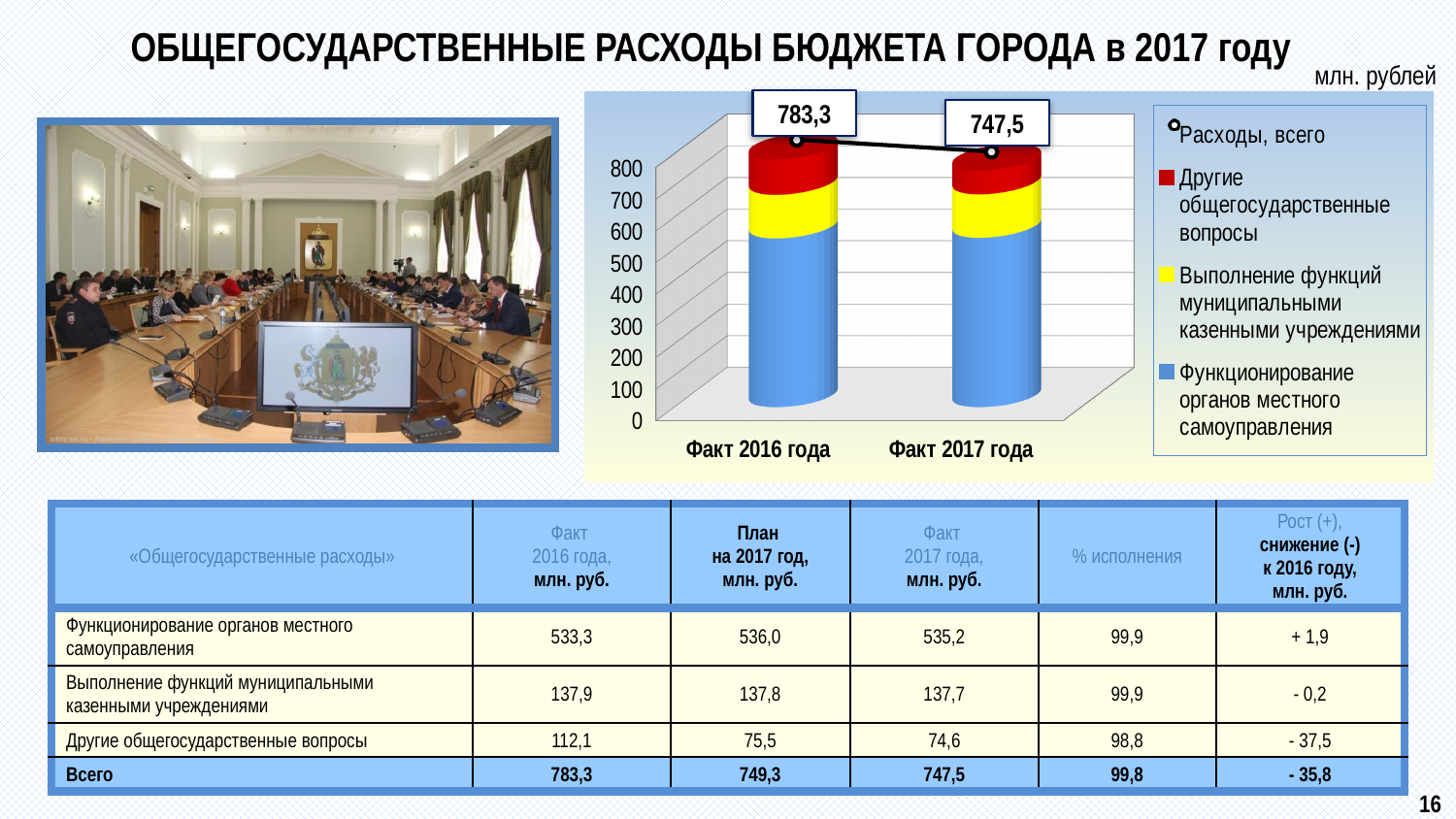
What is the value of «Расходы, всего» for «Факт 2016 года»? 783,3 Which category shows the lowest total expenditure? Факт 2017 года Do the total expenditures rise or fall from «Факт 2016 года» to «Факт 2017 года»? fall What kind of chart is shown on the slide? stacked bar chart How many categories are shown on the x axis of the chart? 2 Is the total for «Факт 2017 года» greater or less than 800? less Which category has the higher total expenditure, «Факт 2016 года» or «Факт 2017 года»? Факт 2016 года What is the difference between the total for «Факт 2016 года» and the total for «Факт 2017 года»? 35,8 How many entries does the chart legend list? 4 Which colour represents «Другие общегосударственные вопросы» in the chart legend? red What is the value of «Расходы, всего» for «Факт 2017 года»? 747,5 Is the blue segment («Функционирование органов местного самоуправления») for «Факт 2016 года» greater or less than 500? greater